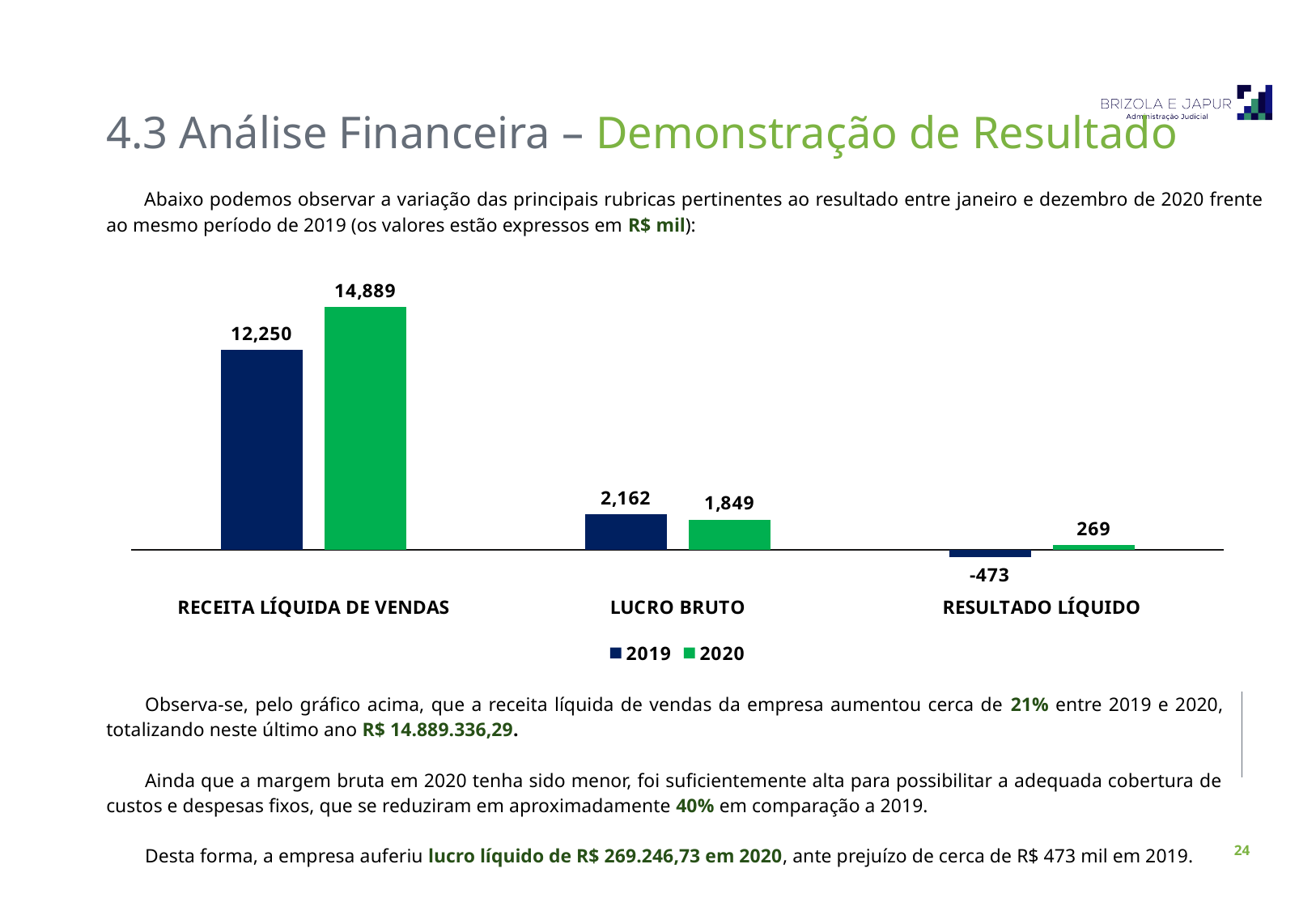
What is the value for LUCRO BRUTO in 2019? 2,162 What kind of chart is shown on the slide? Bar chart Which category has the lowest value in the 2019 series? RESULTADO LÍQUIDO Which is larger for LUCRO BRUTO, the 2019 value or the 2020 value? 2019 How many series does the legend list? 2 What is the difference between the 2020 and 2019 values for RECEITA LÍQUIDA DE VENDAS? 2,639 How many categories are shown on the x axis? 3 Which colour represents the 2020 series in the chart? Green Which category has the highest value in the 2020 series? RECEITA LÍQUIDA DE VENDAS What is the value for RECEITA LÍQUIDA DE VENDAS in 2020? 14,889 What is the value for RESULTADO LÍQUIDO in 2019? -473 What is the value for RESULTADO LÍQUIDO in 2020? 269